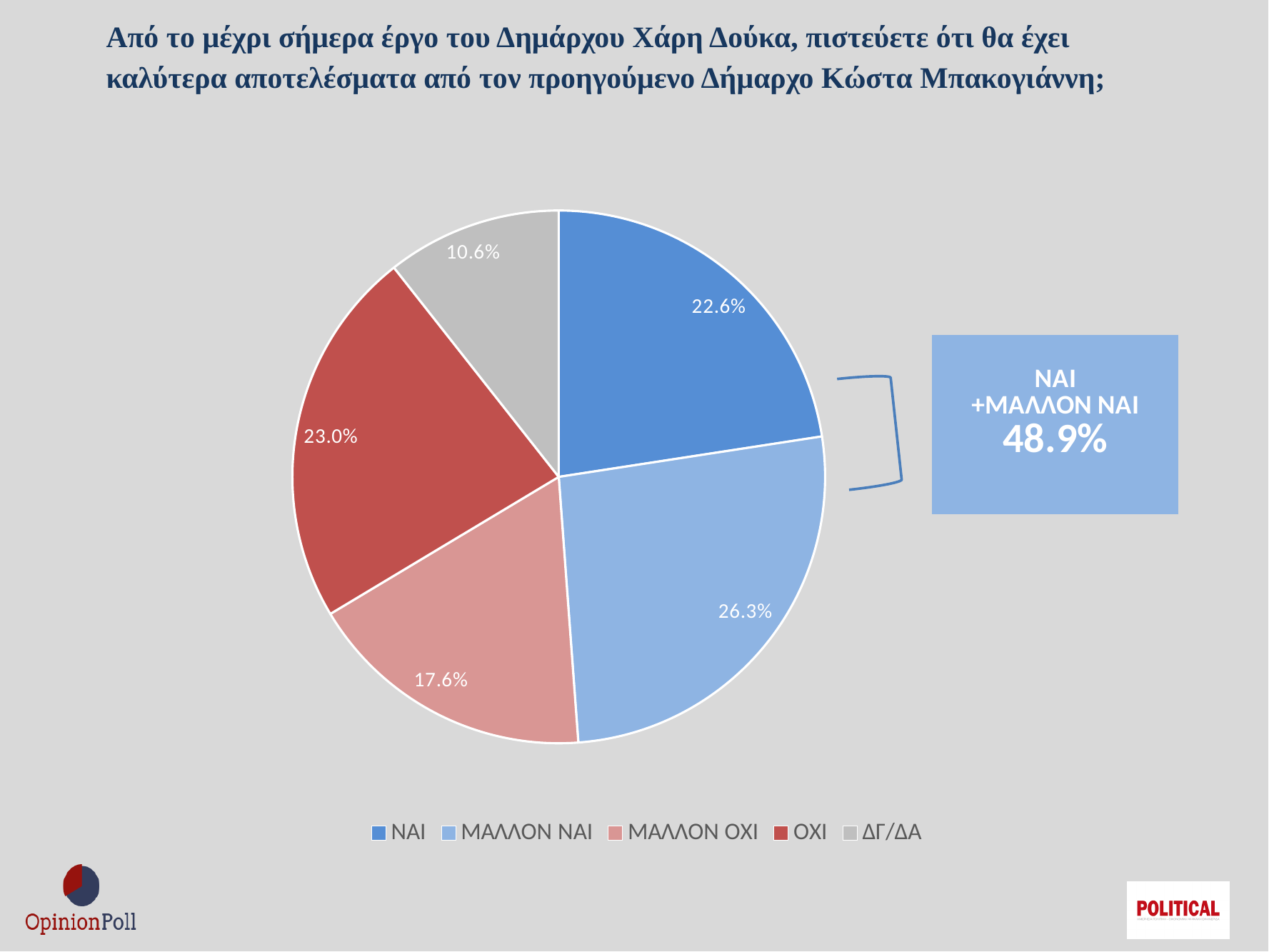
How many slices does the pie chart have? 5 What percentage of respondents answered ΟΧΙ? 23.0% What percentage of respondents answered ΜΑΛΛΟΝ ΝΑΙ? 26.3% What combined percentage does the callout box give for ΝΑΙ + ΜΑΛΛΟΝ ΝΑΙ? 48.9% Which response has the smallest share of the pie? ΔΓ/ΔΑ Which is larger, the share for ΟΧΙ or the share for ΝΑΙ? ΟΧΙ What is the difference in percentage points between ΟΧΙ and ΜΑΛΛΟΝ ΟΧΙ? 5.4 What percentage of respondents answered ΝΑΙ? 22.6% What percentage of respondents answered ΔΓ/ΔΑ? 10.6% What type of chart is shown on the slide? pie chart Which response has the largest share of the pie? ΜΑΛΛΟΝ ΝΑΙ What percentage of respondents answered ΜΑΛΛΟΝ ΟΧΙ? 17.6%